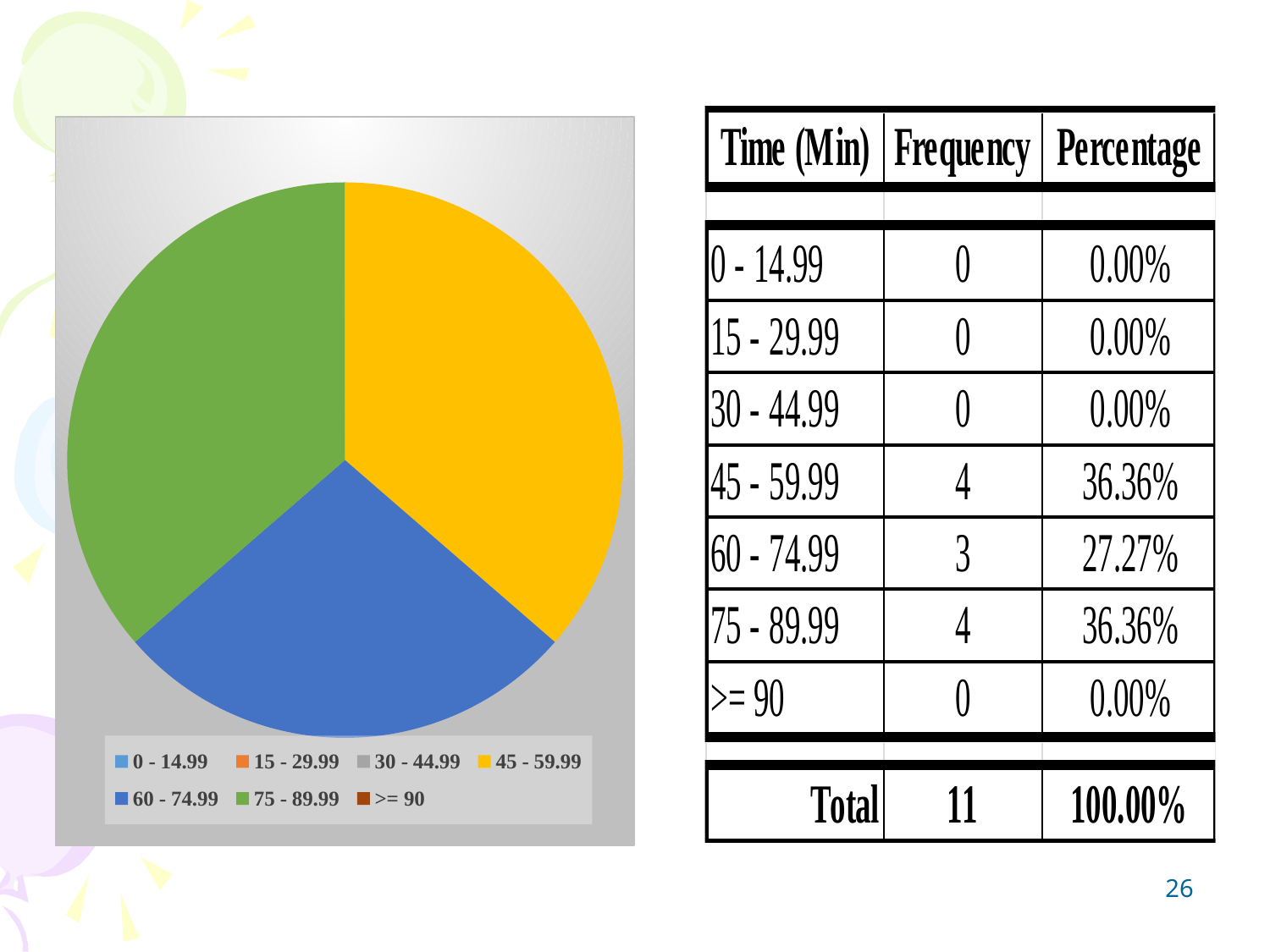
What colour is the slice for the 75 - 89.99 category in the pie chart? green According to the table, what percentage does the 60 - 74.99 category account for? 27.27% How many slices are visible in the pie chart? 3 What is the total frequency shown in the table? 11 Which time category does the blue slice of the pie chart represent? 60 - 74.99 What is the difference in percentage between the 75 - 89.99 category and the 60 - 74.99 category? 9.09% What kind of chart is shown on the left of the slide? pie chart According to the table, what is the frequency for the 45 - 59.99 time category? 4 Which category has the larger frequency, 45 - 59.99 or 60 - 74.99? 45 - 59.99 How many categories does the pie chart's legend list? 7 Which of the visible slices in the pie chart is the smallest? 60 - 74.99 How many time categories in the table have a frequency of 0? 4